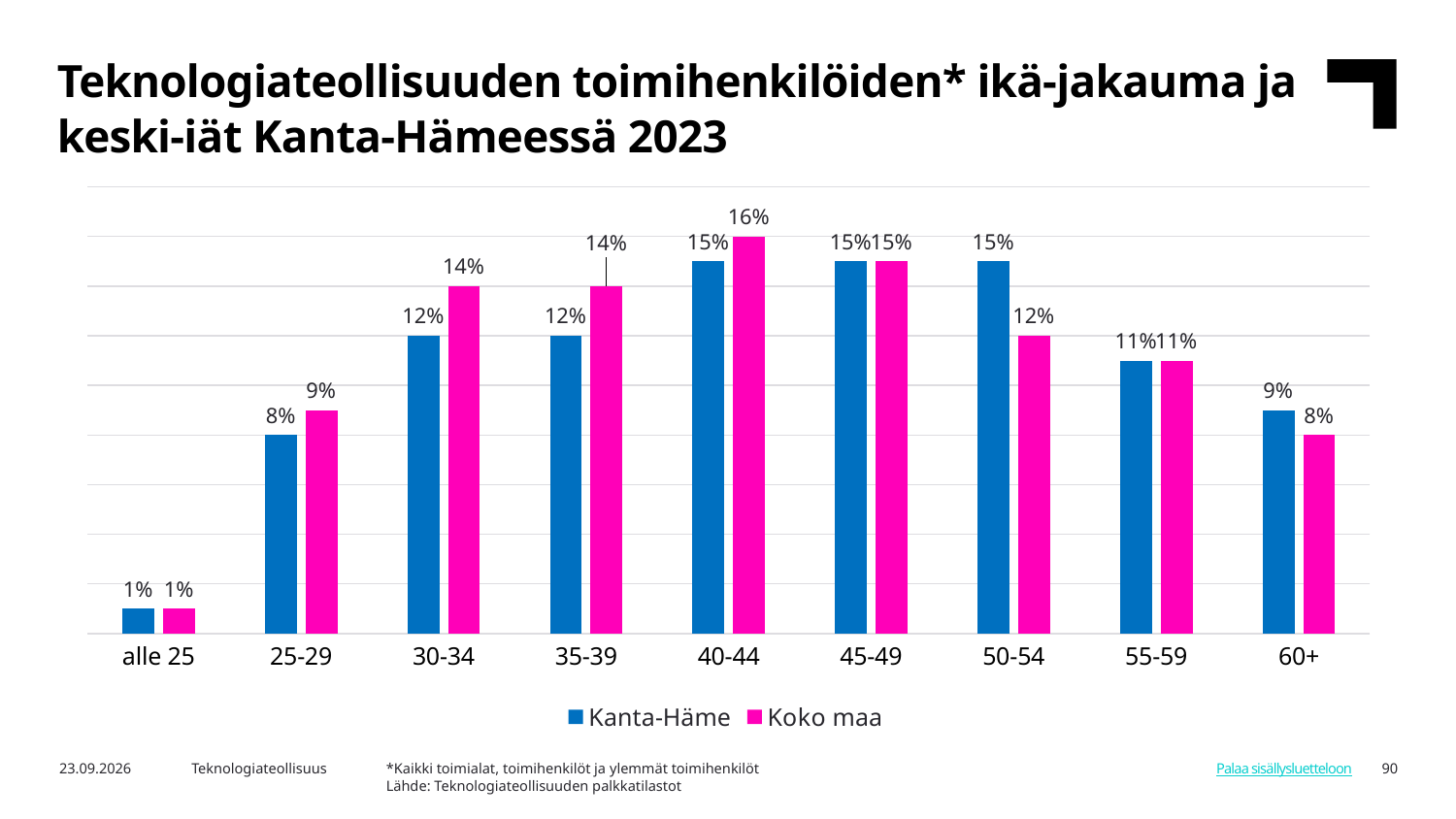
What is the value for Kanta-Häme in the 30-34 age group? 12% What is the difference between Koko maa and Kanta-Häme in the 50-54 age group? 3% Which age group has the highest value for Koko maa? 40-44 What kind of chart is shown on the slide? bar chart How many series does the legend list? 2 Which is larger in the 60+ age group, Kanta-Häme or Koko maa? Kanta-Häme What is the value for Koko maa in the 40-44 age group? 16% Which colour represents the Koko maa series? pink How many age categories are shown on the x axis? 9 Which age group has the lowest value for Kanta-Häme? alle 25 Which is larger in the 35-39 age group, Kanta-Häme or Koko maa? Koko maa What is the value for Kanta-Häme in the 60+ age group? 9%